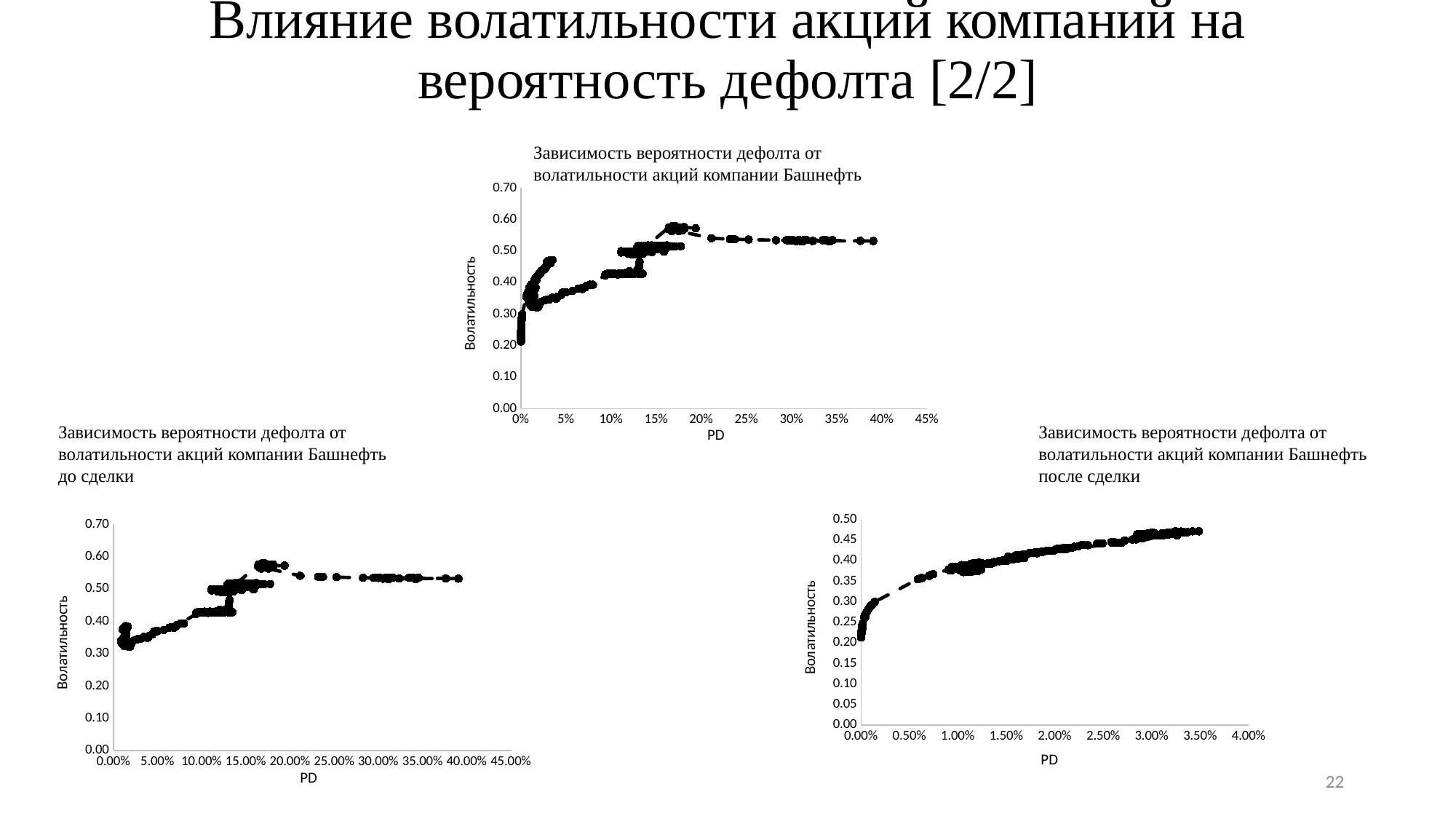
In the top chart, is the volatility at PD around 10% greater or less than 0.50? less In the bottom-left chart ('до сделки'), is the volatility at PD around 40.00% greater or less than 0.50? greater What kind of chart is the top chart titled 'Зависимость вероятности дефолта от волатильности акций компании Башнефть'? scatter chart In the bottom-right chart ('после сделки'), do the volatility values rise or fall as PD increases along the x axis? rise In the bottom-right chart ('после сделки'), is the volatility at PD around 3.50% greater or less than 0.40? greater In the bottom-right chart ('после сделки'), what is the label of the vertical axis? Волатильность In the bottom-left chart ('до сделки'), do the volatility values generally rise or fall as PD increases from 0.00% to 20.00%? rise How many charts are shown on the slide? 3